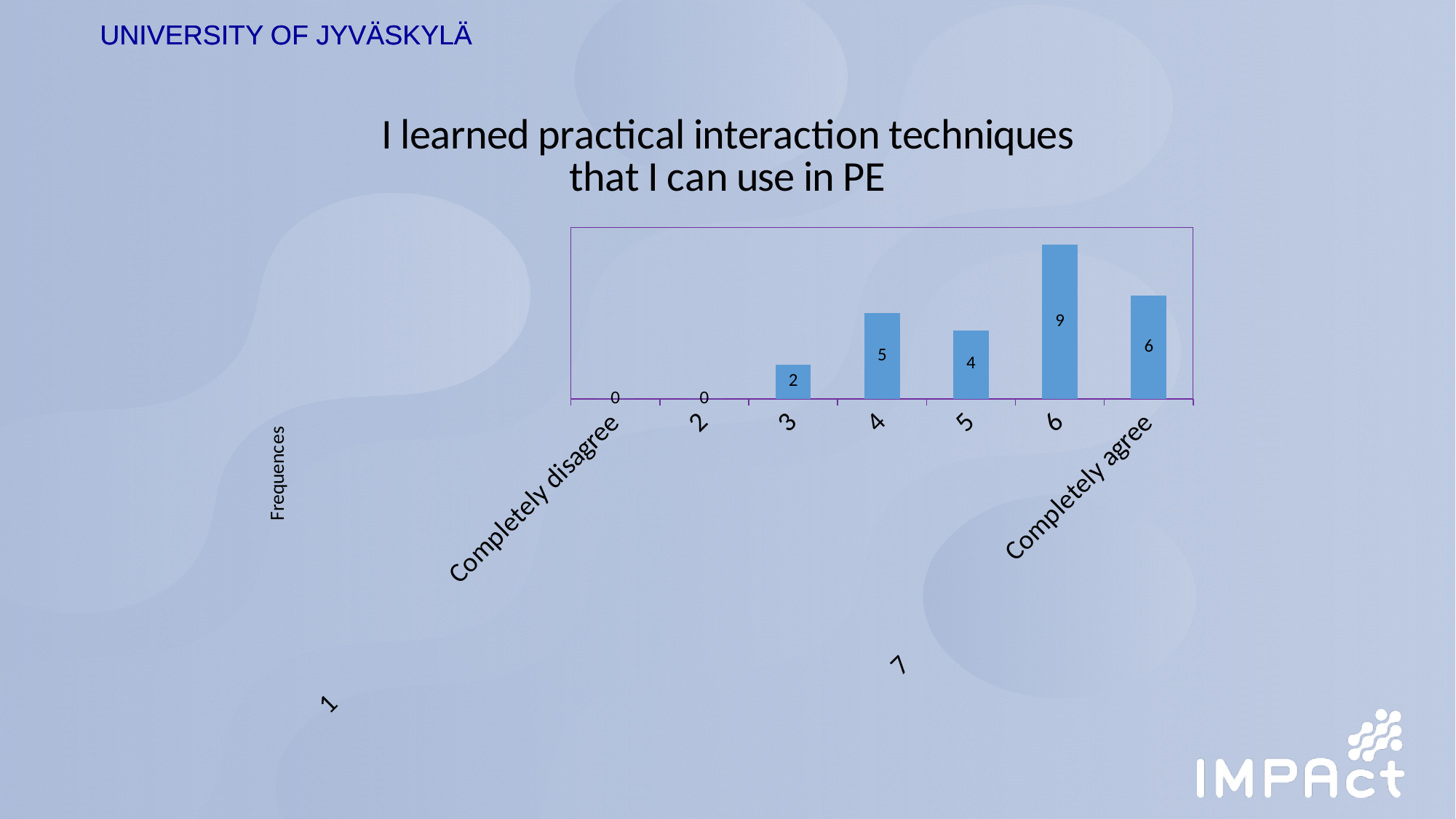
What is the frequency for category 4? 5 What is the label of the vertical axis? Frequences What is the frequency for category 6? 9 What is the frequency for 'Completely disagree'? 0 What is the title of the chart? I learned practical interaction techniques that I can use in PE Which category has the highest frequency? 6 Which has a higher frequency, category 4 or category 5? 4 What is the frequency for 'Completely agree'? 6 How many categories are shown on the x axis? 7 What is the frequency for category 3? 2 What type of chart is shown on the slide? bar chart What is the difference between the frequencies for category 6 and category 5? 5